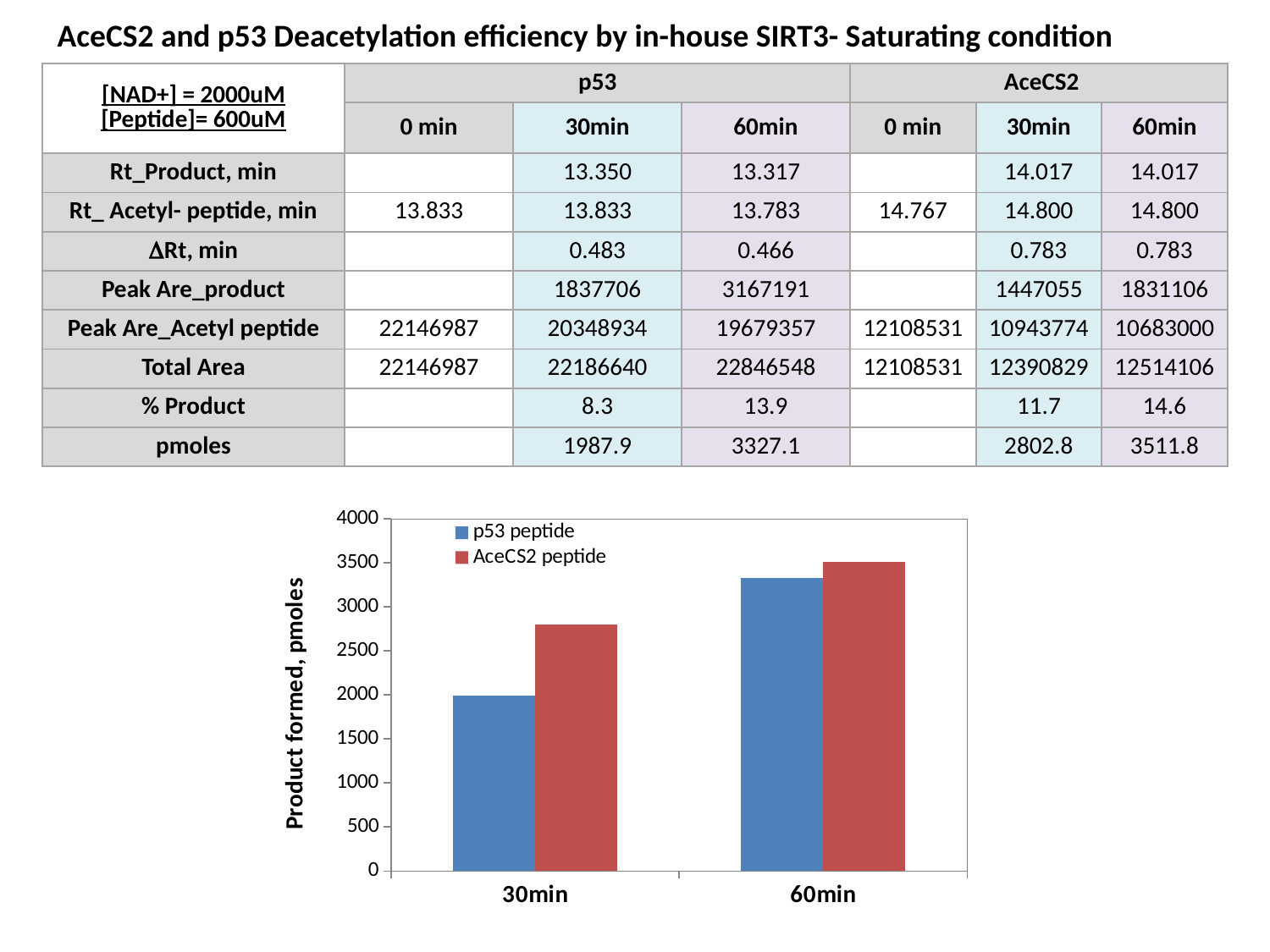
How many time-point categories are shown on the x axis of the chart? 2 Is the value for p53 peptide at 30min greater or less than 2500? less Is the value for AceCS2 peptide at 30min greater or less than 2500? greater What is the y-axis label of the chart? Product formed, pmoles Which series has the larger value at 30min, p53 peptide or AceCS2 peptide? AceCS2 peptide According to the table, how many pmoles of product were formed for p53 peptide at 30min? 1987.9 Is the value for p53 peptide at 60min greater or less than 3000? greater How many series does the chart legend list? 2 What kind of chart is shown on the slide? bar chart According to the table, how many pmoles of product were formed for AceCS2 peptide at 60min? 3511.8 Does the product formed for p53 peptide rise or fall from 30min to 60min? rise Which series is shown in red in the chart? AceCS2 peptide